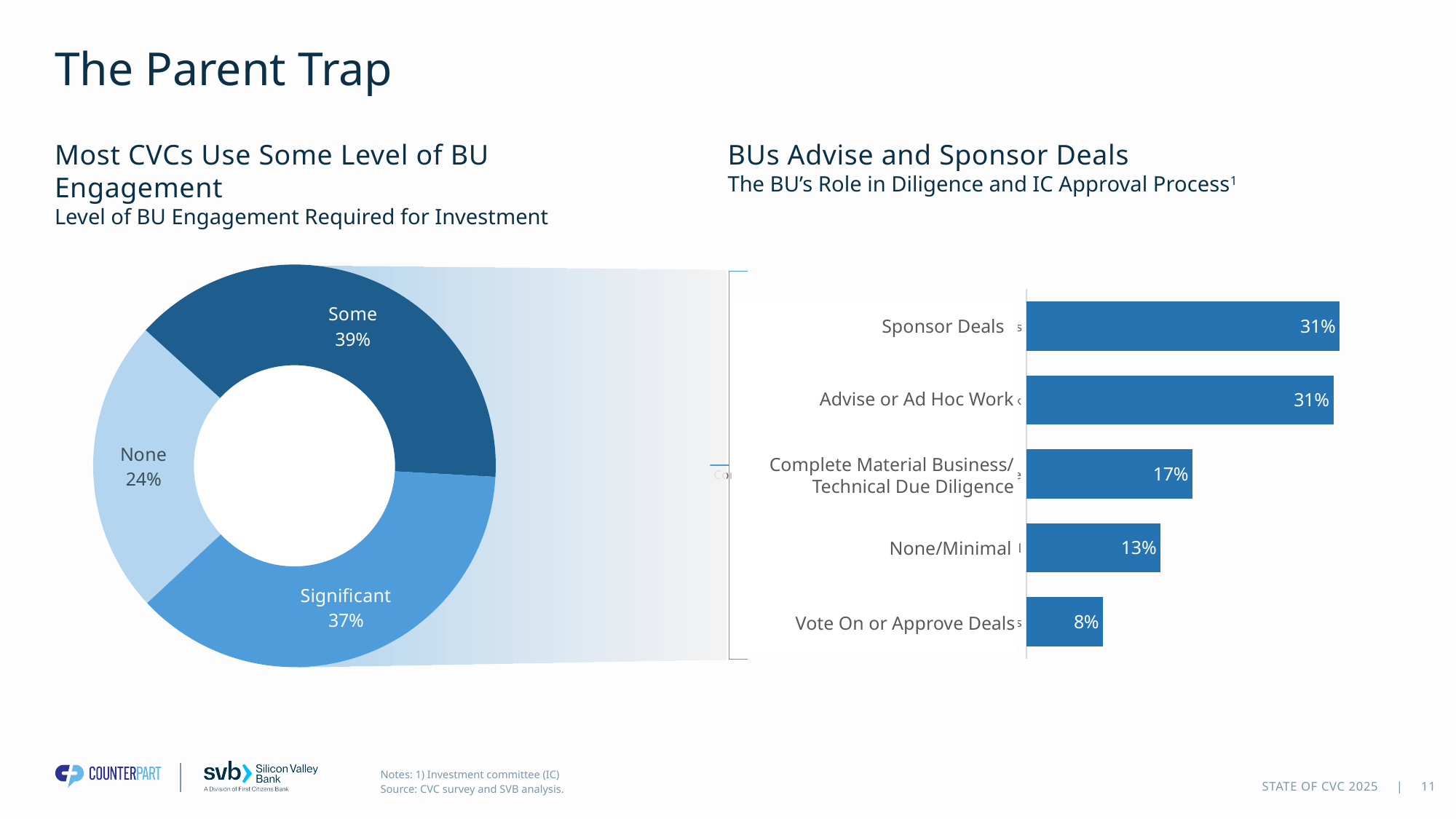
In the 'Level of BU Engagement Required for Investment' chart, what share is labelled 'Some'? 39% In the 'Level of BU Engagement Required for Investment' chart, what share is labelled 'None'? 24% What kind of chart is the 'The BU's Role in Diligence and IC Approval Process' chart? Bar chart In the 'Level of BU Engagement Required for Investment' chart, which category has the smallest share? None In the 'Level of BU Engagement Required for Investment' chart, how many categories are shown? 3 In the 'Level of BU Engagement Required for Investment' chart, what is the difference between the 'Some' and 'Significant' shares? 2% In the 'The BU's Role in Diligence and IC Approval Process' chart, what is the value for 'Vote On or Approve Deals'? 8% In the 'The BU's Role in Diligence and IC Approval Process' chart, which category has the lowest value? Vote On or Approve Deals What kind of chart is the 'Level of BU Engagement Required for Investment' chart? Doughnut chart In the 'The BU's Role in Diligence and IC Approval Process' chart, what is the difference between 'Sponsor Deals' and 'None/Minimal'? 18% In the 'The BU's Role in Diligence and IC Approval Process' chart, what is the value for 'Complete Material Business/Technical Due Diligence'? 17% In the 'Level of BU Engagement Required for Investment' chart, which category has the largest share? Some